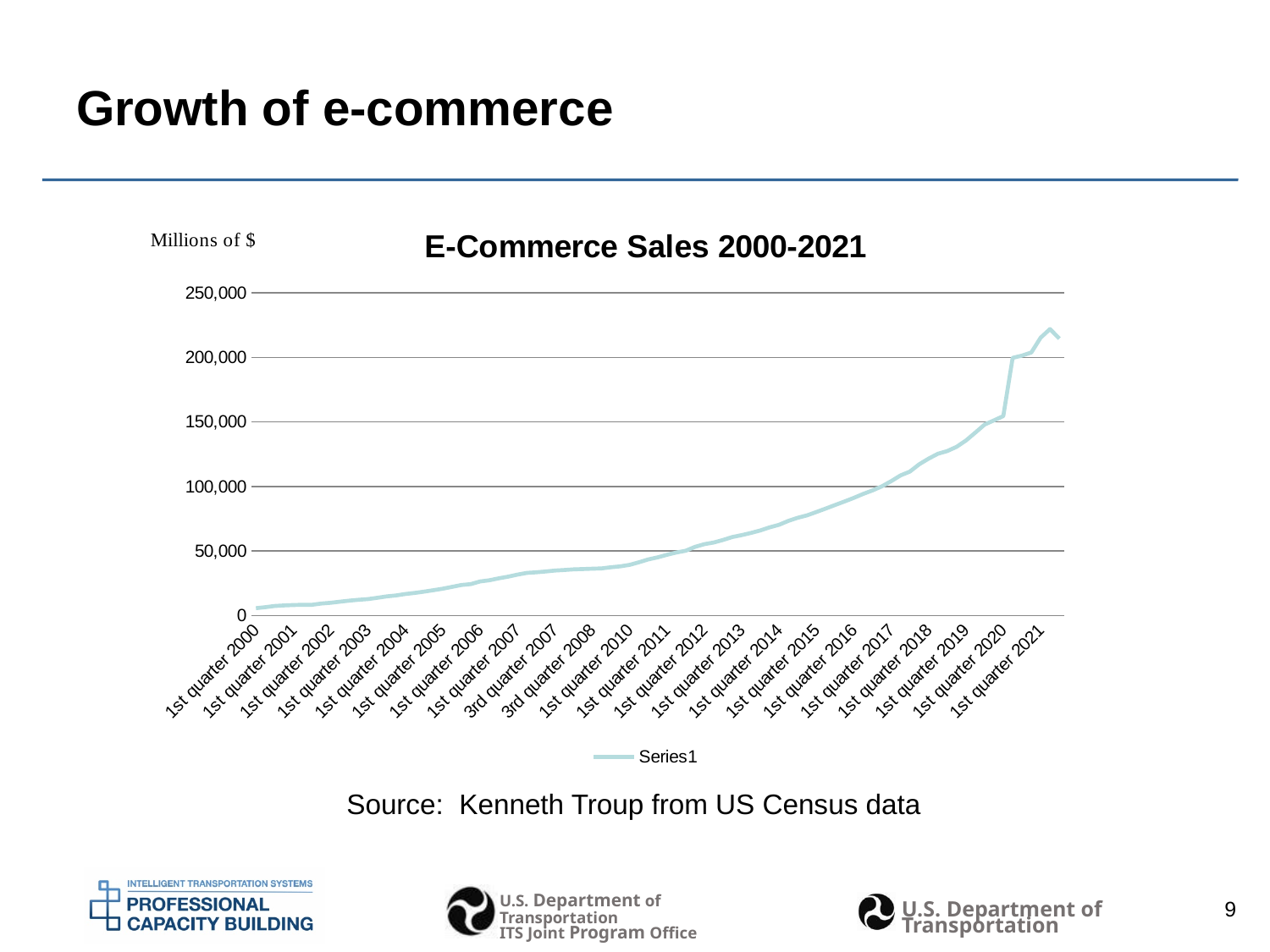
What kind of chart is shown on the slide? line chart What unit is given for the values on the chart's vertical axis? Millions of $ Is the value for 1st quarter 2019 greater or less than 100,000? greater Is the value for 1st quarter 2010 greater or less than 50,000? less How many series does the legend list? 1 What is the title of the chart? E-Commerce Sales 2000-2021 Is the value for 1st quarter 2014 greater or less than 50,000? greater Which is larger, the value for 1st quarter 2020 or the value for 1st quarter 2010? 1st quarter 2020 Which labelled quarter has the lowest e-commerce sales value? 1st quarter 2000 Do e-commerce sales generally rise or fall from 2000 to 2021 along the x axis? rise